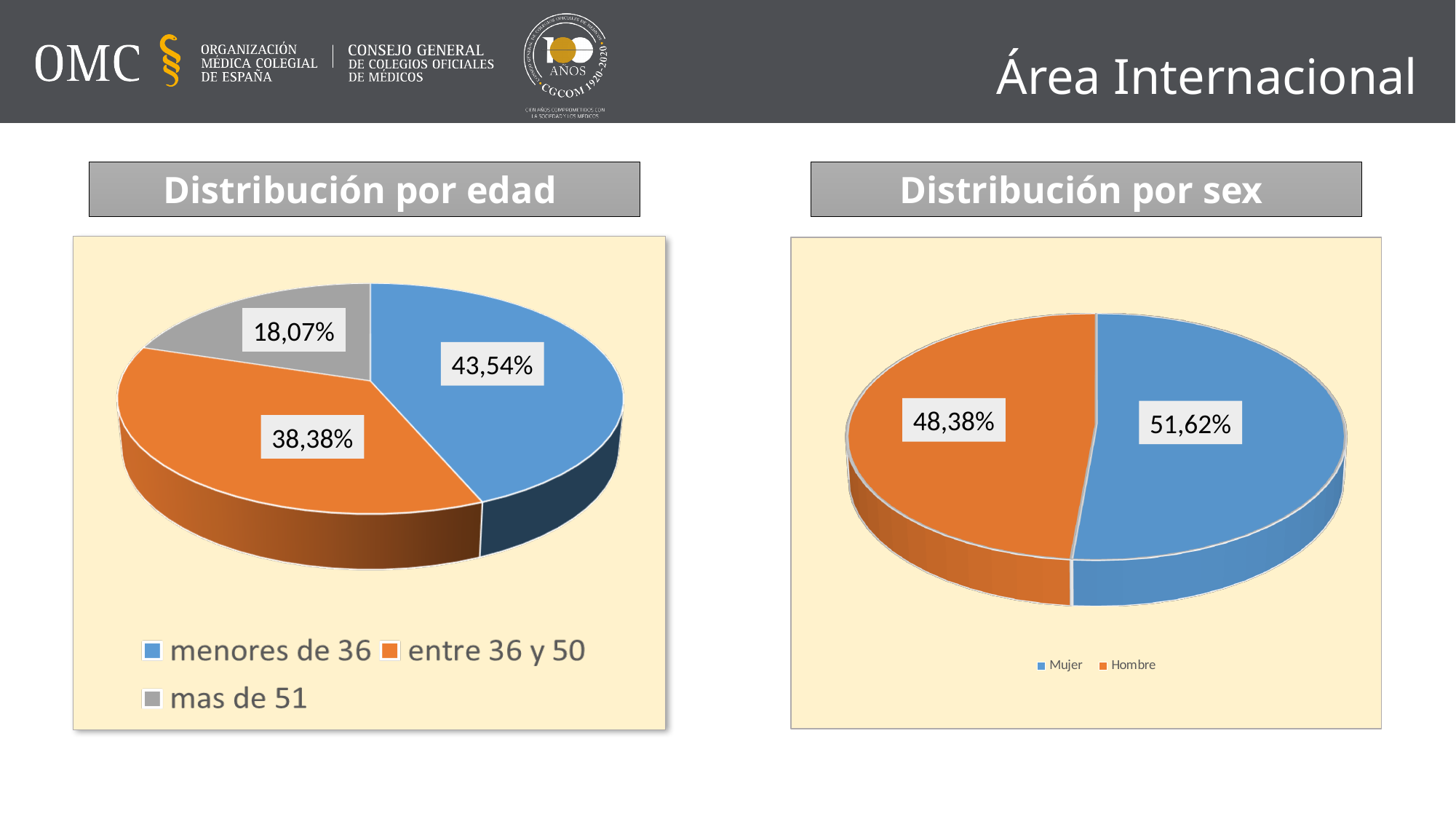
In the 'Distribución por edad' chart, what colour is the slice for 'mas de 51'? Grey In the 'Distribución por edad' chart, how many categories does the legend list? 3 In the 'Distribución por edad' chart, what is the difference in percentage points between 'menores de 36' and 'entre 36 y 50'? 5,16 In the 'Distribución por edad' chart, what share is shown for 'mas de 51'? 18,07% In the 'Distribución por edad' chart, which category has the largest slice? menores de 36 In the 'Distribución por edad' chart, what share is shown for 'menores de 36'? 43,54% In the 'Distribución por sex' chart, what share is shown for 'Hombre'? 48,38% In the 'Distribución por sex' chart, which category has the larger slice, 'Mujer' or 'Hombre'? Mujer What kind of chart is the 'Distribución por sex' chart? Pie chart In the 'Distribución por edad' chart, which category has the smallest slice? mas de 51 In the 'Distribución por edad' chart, what share is shown for 'entre 36 y 50'? 38,38% In the 'Distribución por sex' chart, what share is shown for 'Mujer'? 51,62%